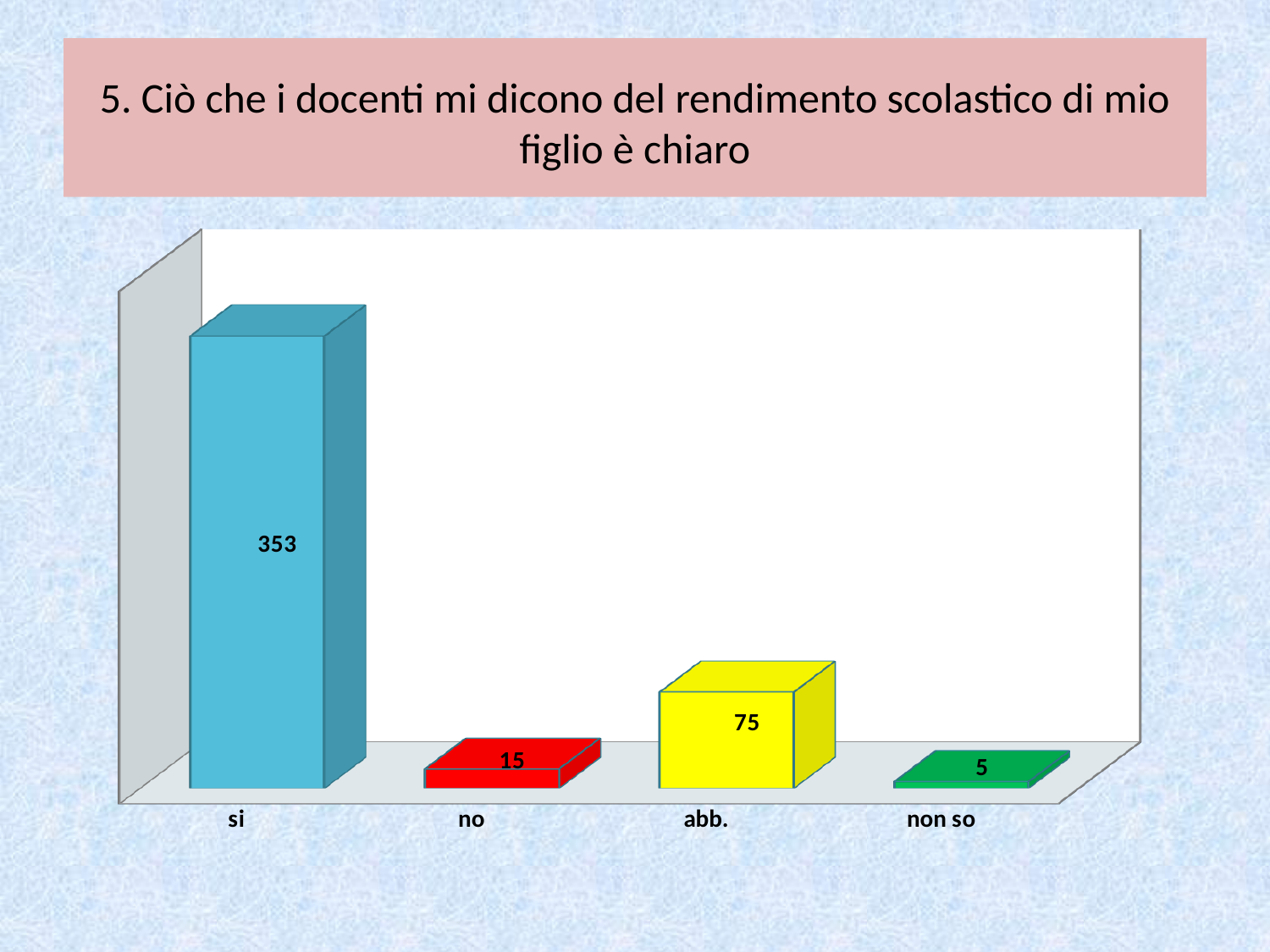
What colour is the bar for "abb."? yellow What is the value for "no"? 15 What is the difference between the values for "no" and "non so"? 10 What is the value for "si"? 353 What kind of chart is shown on the slide? bar chart Which is larger, the value for "no" or the value for "abb."? abb. What is the value for "abb."? 75 How many categories are shown on the x axis? 4 Which category has the highest value? si Which category has the lowest value? non so What is the value for "non so"? 5 What is the difference between the values for "si" and "abb."? 278